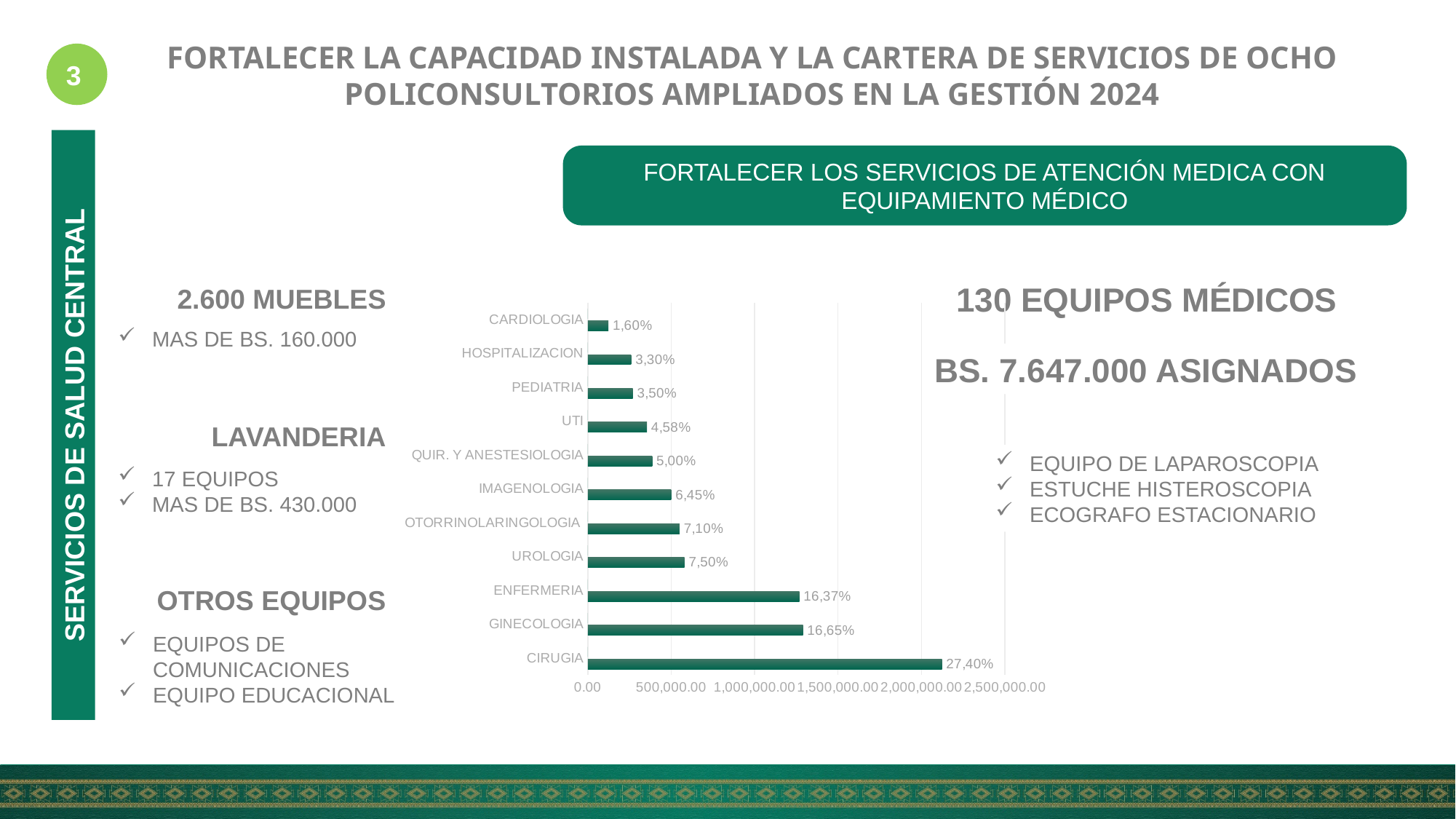
Is the value for CIRUGIA on the x axis greater or less than 2,000,000.00? greater What is the data label shown for IMAGENOLOGIA? 6,45% What type of chart is shown on the slide? Bar chart Which category has the lowest value in the chart? CARDIOLOGIA What is the data label shown for CIRUGIA? 27,40% Which category has the highest value in the chart? CIRUGIA Which has a larger value, UROLOGIA or PEDIATRIA? UROLOGIA What is the data label shown for UTI? 4,58% Is the value for CARDIOLOGIA on the x axis greater or less than 500,000.00? less What is the difference between the data labels for CIRUGIA and GINECOLOGIA? 10,75% How many categories are shown in the chart? 11 What is the data label shown for CARDIOLOGIA? 1,60%